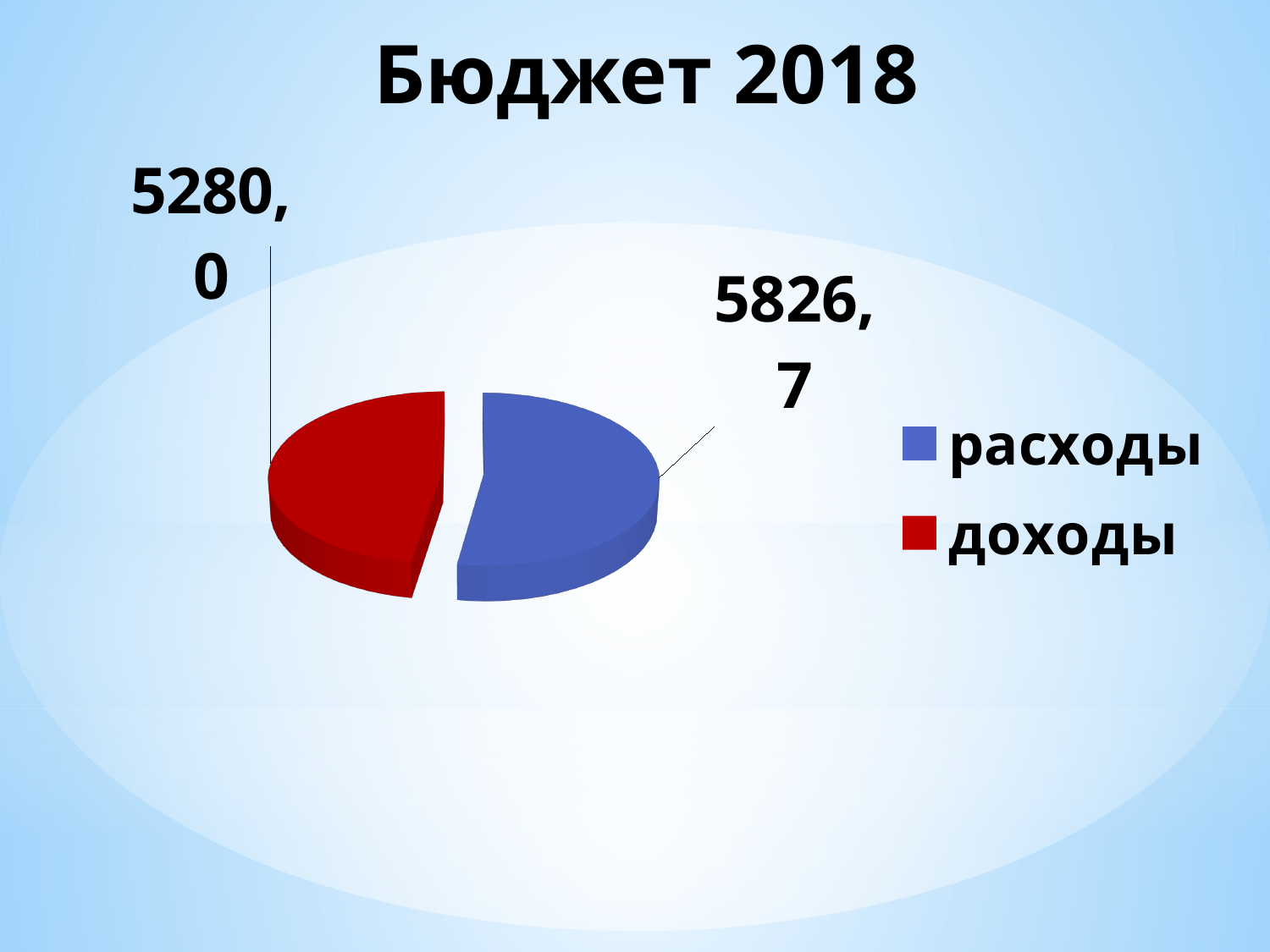
What kind of chart is shown on the slide? pie chart Which category has the smallest slice of the pie? доходы How many slices does the pie chart have? 2 What is the difference between расходы and доходы? 546,7 What is the value for расходы? 5826,7 What is the total of расходы and доходы? 11106,7 Which is larger, расходы or доходы? расходы Which category has the largest slice of the pie? расходы What is the title of the chart? Бюджет 2018 How many entries does the legend list? 2 What colour is the slice for доходы? red What is the value for доходы? 5280,0